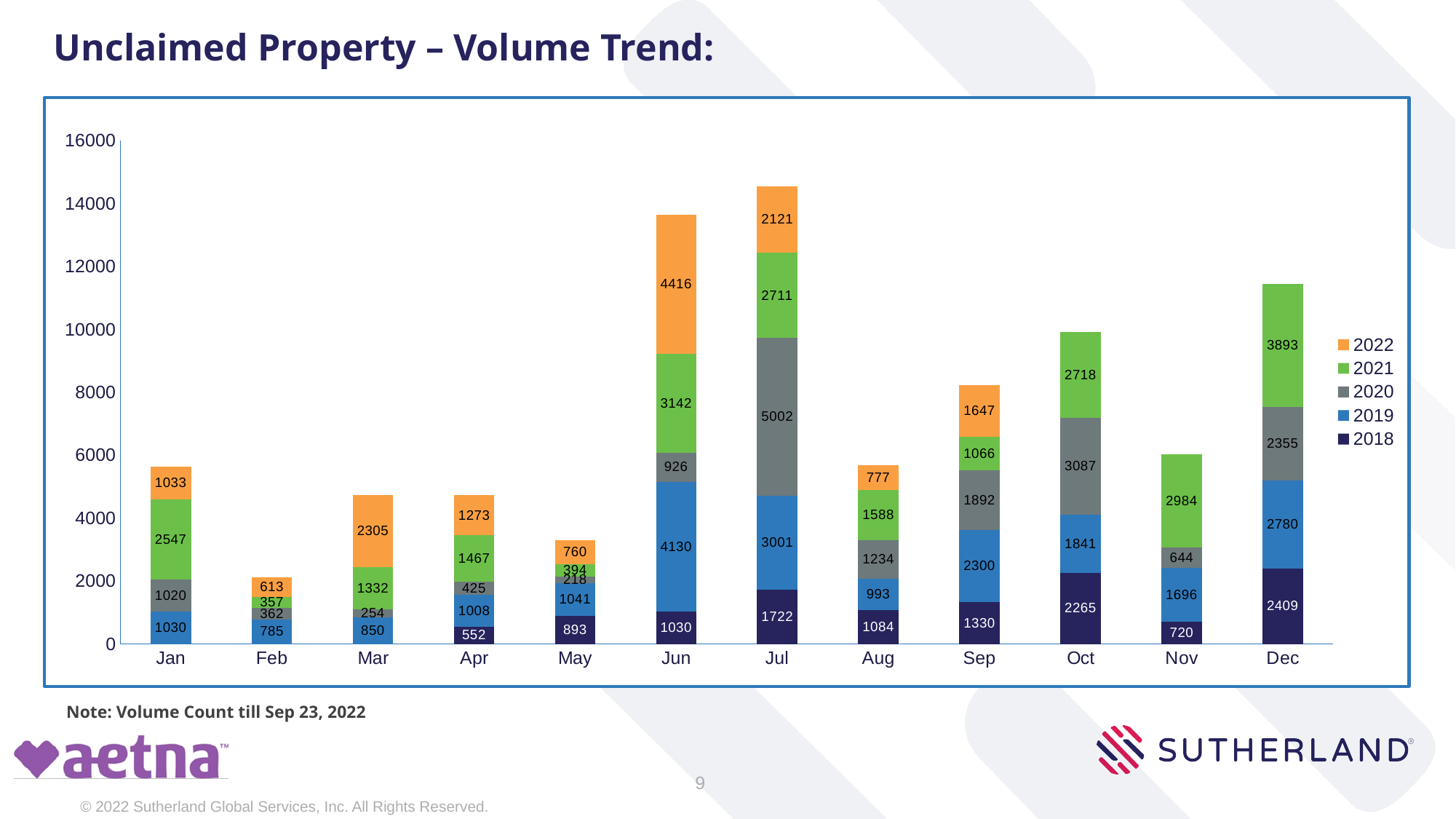
What is the 2018 value for Oct? 2265 Is the total of the stacked bar for Oct greater or less than 8000? greater What kind of chart is shown on the slide? Stacked bar chart Which month has the shortest stacked bar overall? Feb What is the difference between the 2021 value for Dec and the 2021 value for Nov? 909 How many series does the legend list? 5 What is the total of the stacked bar for Dec? 11437 What is the 2022 value for Jun? 4416 Which month has the tallest stacked bar overall? Jul Which is larger, the 2019 value for Jun or the 2019 value for Jul? Jun What is the 2020 value for Jul? 5002 How many months are shown on the x axis? 12